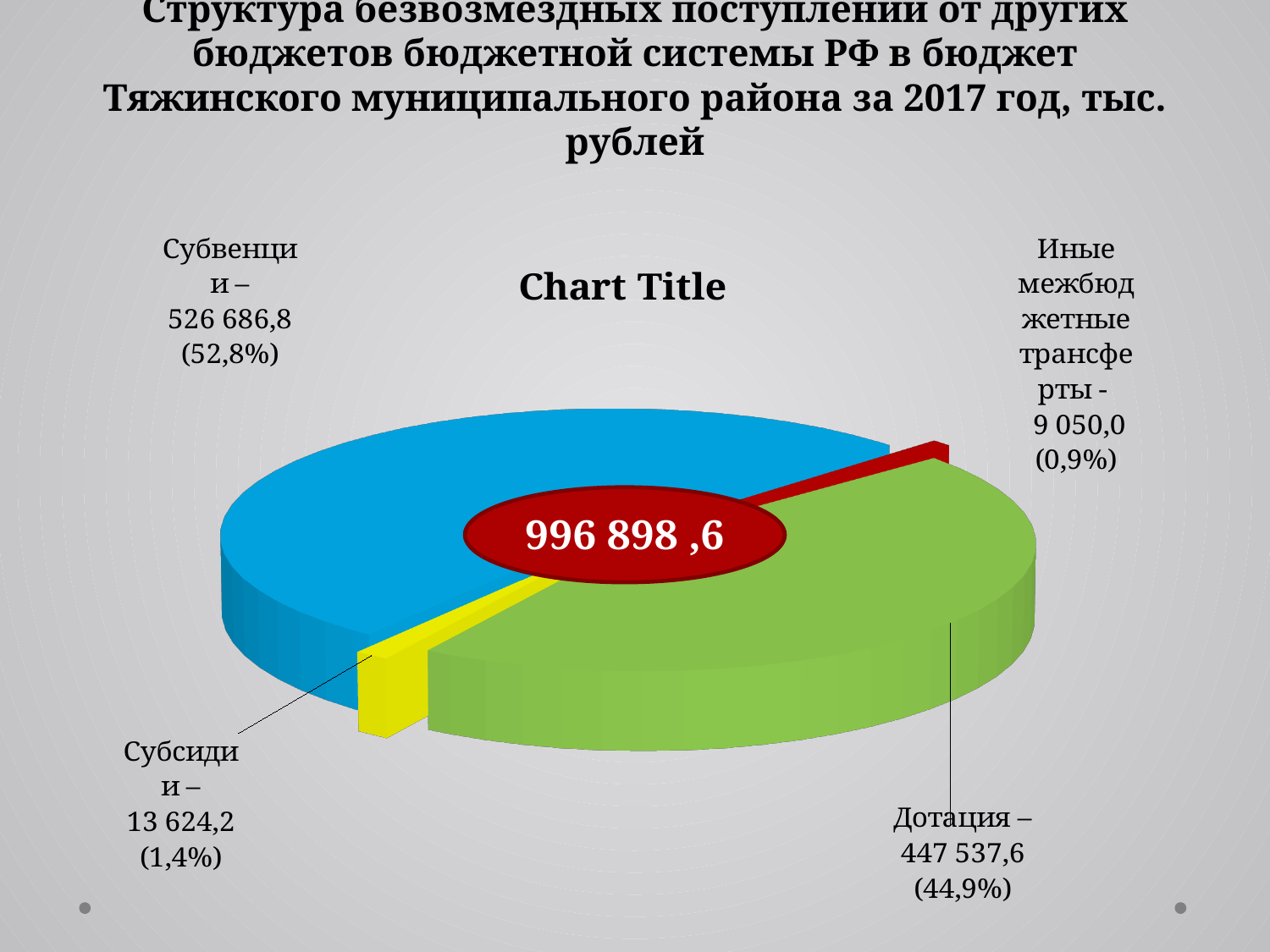
How many slices does the pie chart have? 4 Which category has the largest slice? Субвенции What total value is printed in the centre of the pie chart? 996 898 ,6 What is the value for Субвенции? 526 686,8 What is the value for Иные межбюджетные трансферты? 9 050,0 Which category has the smallest slice? Иные межбюджетные трансферты Which is larger, Субсидии or Иные межбюджетные трансферты? Субсидии What kind of chart is shown on the slide? pie chart What is the value for Субсидии? 13 624,2 What share of the pie does Субвенции represent? 52,8% What share of the pie does Дотация represent? 44,9% What is the value for Дотация? 447 537,6